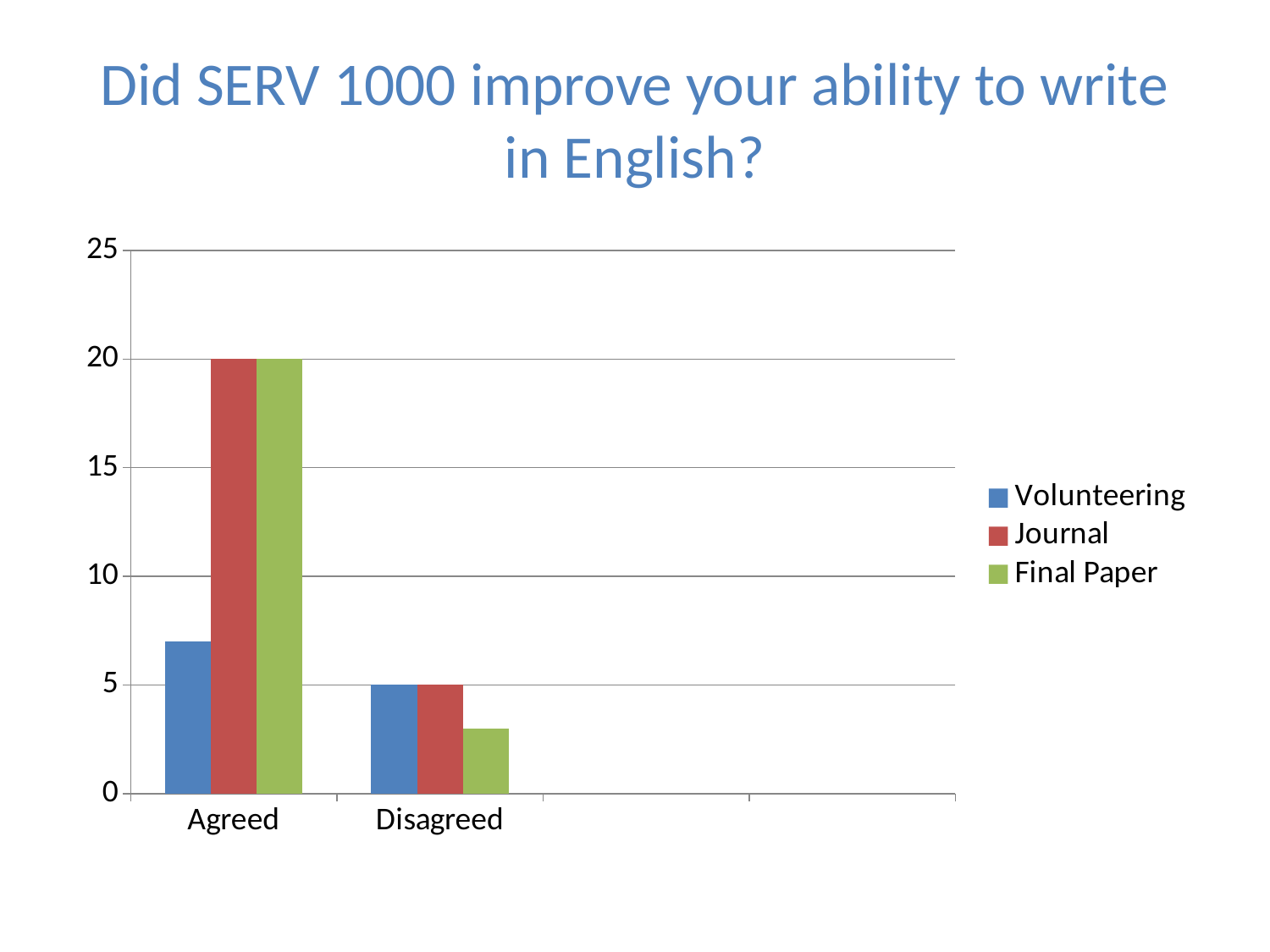
What is the value for Journal in the Agreed category? 20 What is the value for Final Paper in the Agreed category? 20 How many series does the legend list? 3 In the Agreed category, which is larger: Journal or Volunteering? Journal How many categories are shown on the x axis? 2 What is the title of the slide? Did SERV 1000 improve your ability to write in English? What kind of chart is shown on the slide? bar chart What is the difference between the Journal value for Agreed and the Journal value for Disagreed? 15 Is the value for Final Paper in the Disagreed category greater or less than 5? less What is the value for Volunteering in the Disagreed category? 5 In the Agreed category, which series has the lowest value? Volunteering Is the value for Volunteering in the Agreed category greater or less than 10? less